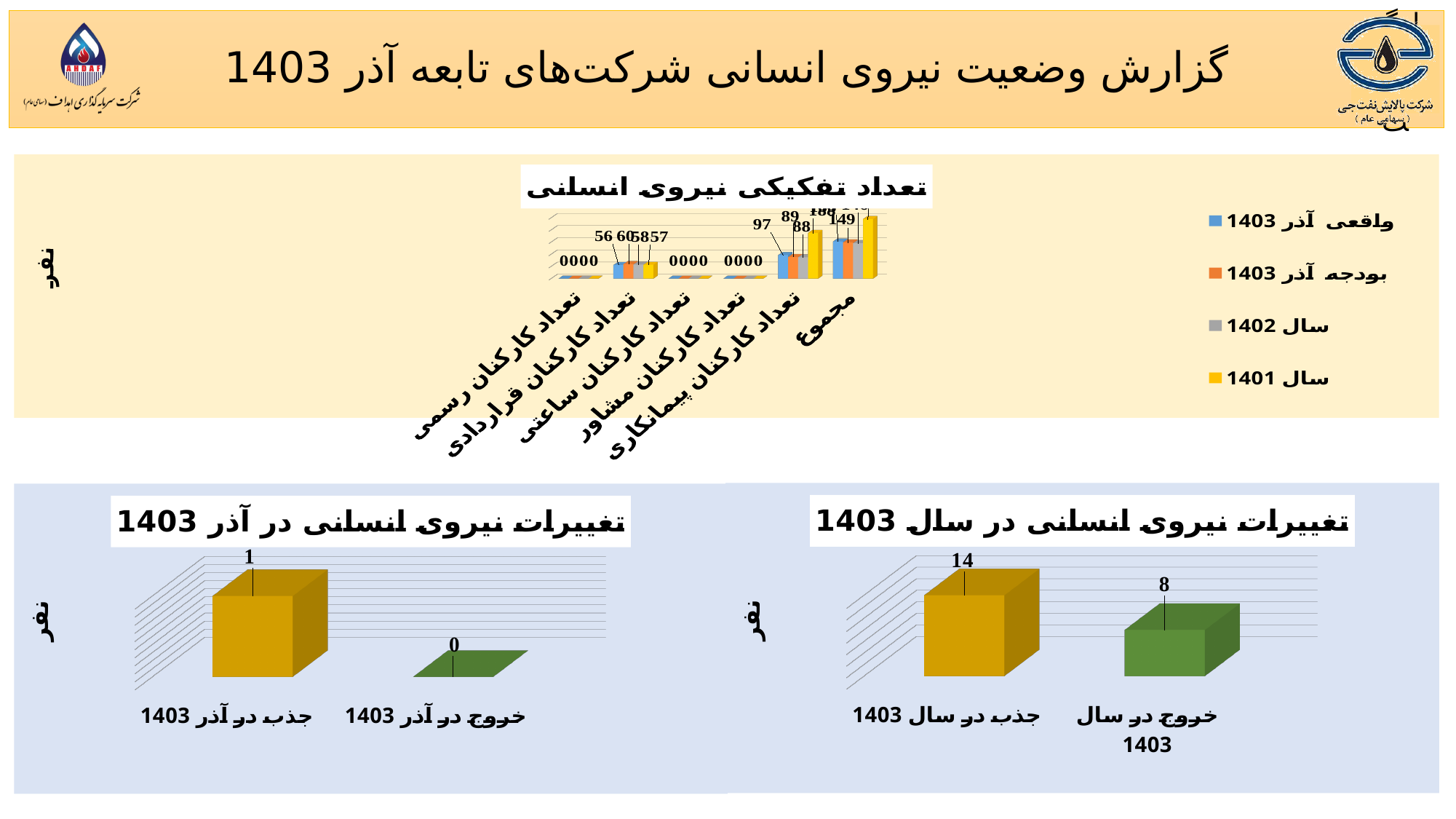
In the chart titled "تعداد تفکیکی نیروی انسانی", how many series does the legend list? 4 In the chart titled "تغییرات نیروی انسانی در سال 1403", how many categories are shown? 2 In the chart titled "تغییرات نیروی انسانی در سال 1403", what is the value for "جذب در سال 1403"? 14 What kind of chart is the one titled "تعداد تفکیکی نیروی انسانی"? bar chart In the chart titled "تغییرات نیروی انسانی در آذر 1403", what is the value for "جذب در آذر 1403"? 1 In the chart titled "تغییرات نیروی انسانی در سال 1403", what is the difference between "جذب در سال 1403" and "خروج در سال 1403"? 6 In the chart titled "تغییرات نیروی انسانی در آذر 1403", what is the value for "خروج در آذر 1403"? 0 In the chart titled "تغییرات نیروی انسانی در آذر 1403", which category has the higher value? جذب در آذر 1403 In the chart titled "تغییرات نیروی انسانی در سال 1403", what is the value for "خروج در سال 1403"? 8 In the chart titled "تعداد تفکیکی نیروی انسانی", what is the value of "واقعی آذر 1403" for "تعداد کارکنان پیمانکاری"? 97 In the chart titled "تعداد تفکیکی نیروی انسانی", how many categories are shown on the x axis? 6